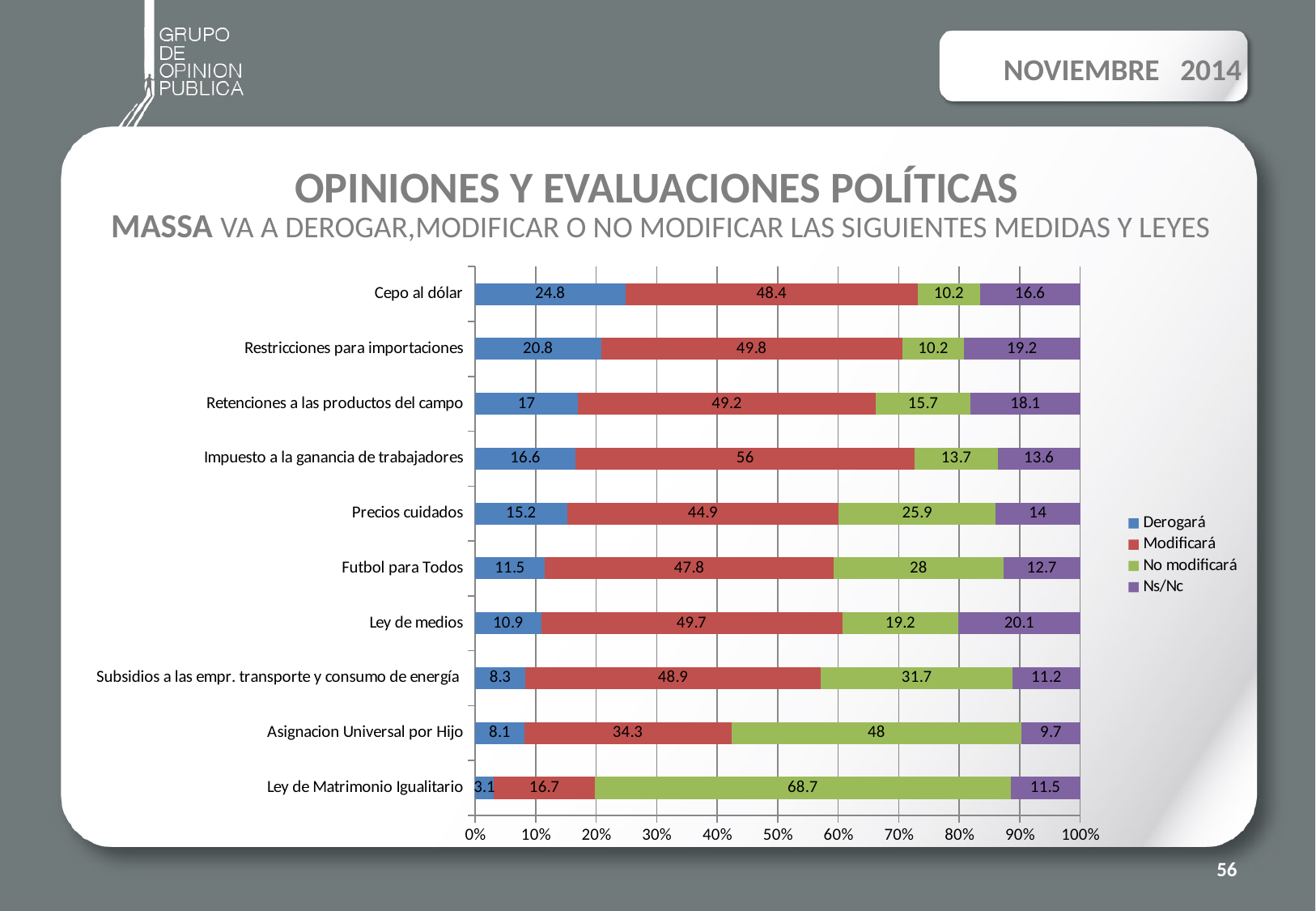
What is the difference between the No modificará values for Ley de Matrimonio Igualitario and Asignacion Universal por Hijo? 20.7 What is the total of the stacked bar for Cepo al dólar? 100 How many series does the legend list? 4 How many categories are shown on the chart? 10 Which is larger: the Modificará value for Cepo al dólar or for Asignacion Universal por Hijo? Cepo al dólar Which category has the highest Derogará value? Cepo al dólar What is the Ns/Nc value for Ley de medios? 20.1 What is the No modificará value for Ley de Matrimonio Igualitario? 68.7 What is the Modificará value for Impuesto a la ganancia de trabajadores? 56 Which category has the highest Modificará value? Impuesto a la ganancia de trabajadores What kind of chart is shown on the slide? Stacked bar chart Which category has the lowest Derogará value? Ley de Matrimonio Igualitario